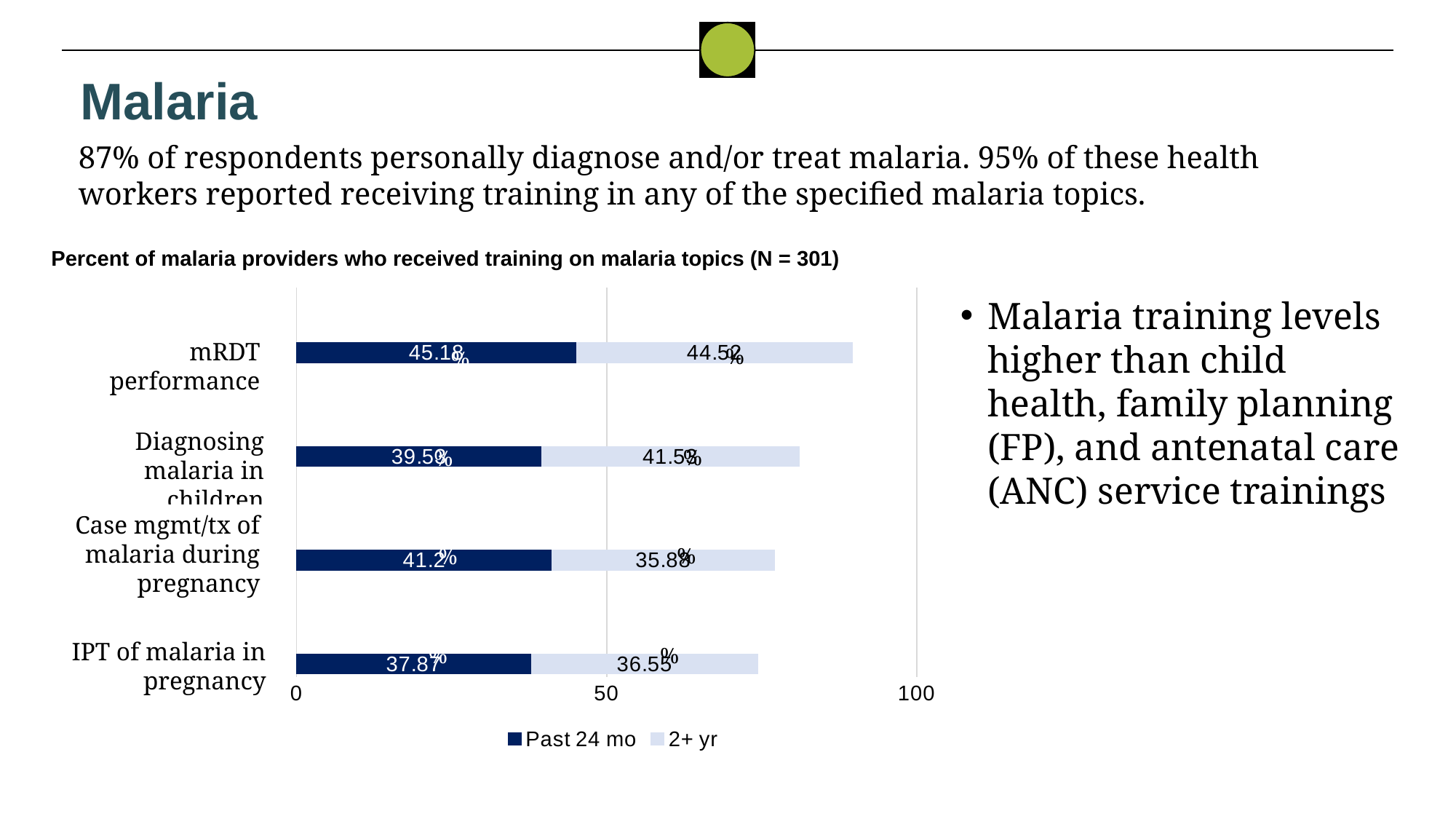
How many malaria topics (categories) are plotted in the chart? 4 What percent of malaria providers received training on mRDT performance in the past 24 months? 45.18% Is the total stacked bar for mRDT performance greater or less than 50? greater What kind of chart is shown on the slide? Stacked bar chart Which malaria topic has the highest 'Past 24 mo' training value? mRDT performance Which malaria topic has the lowest '2+ yr' training value? Case mgmt/tx of malaria during pregnancy What is the '2+ yr' value for IPT of malaria in pregnancy? 36.55% What are the two series named in the chart legend? Past 24 mo and 2+ yr For diagnosing malaria in children, which is larger: the 'Past 24 mo' value or the '2+ yr' value? 2+ yr What percent of malaria providers received training on diagnosing malaria in children 2+ years ago? 41.53% How many series does the chart legend list? 2